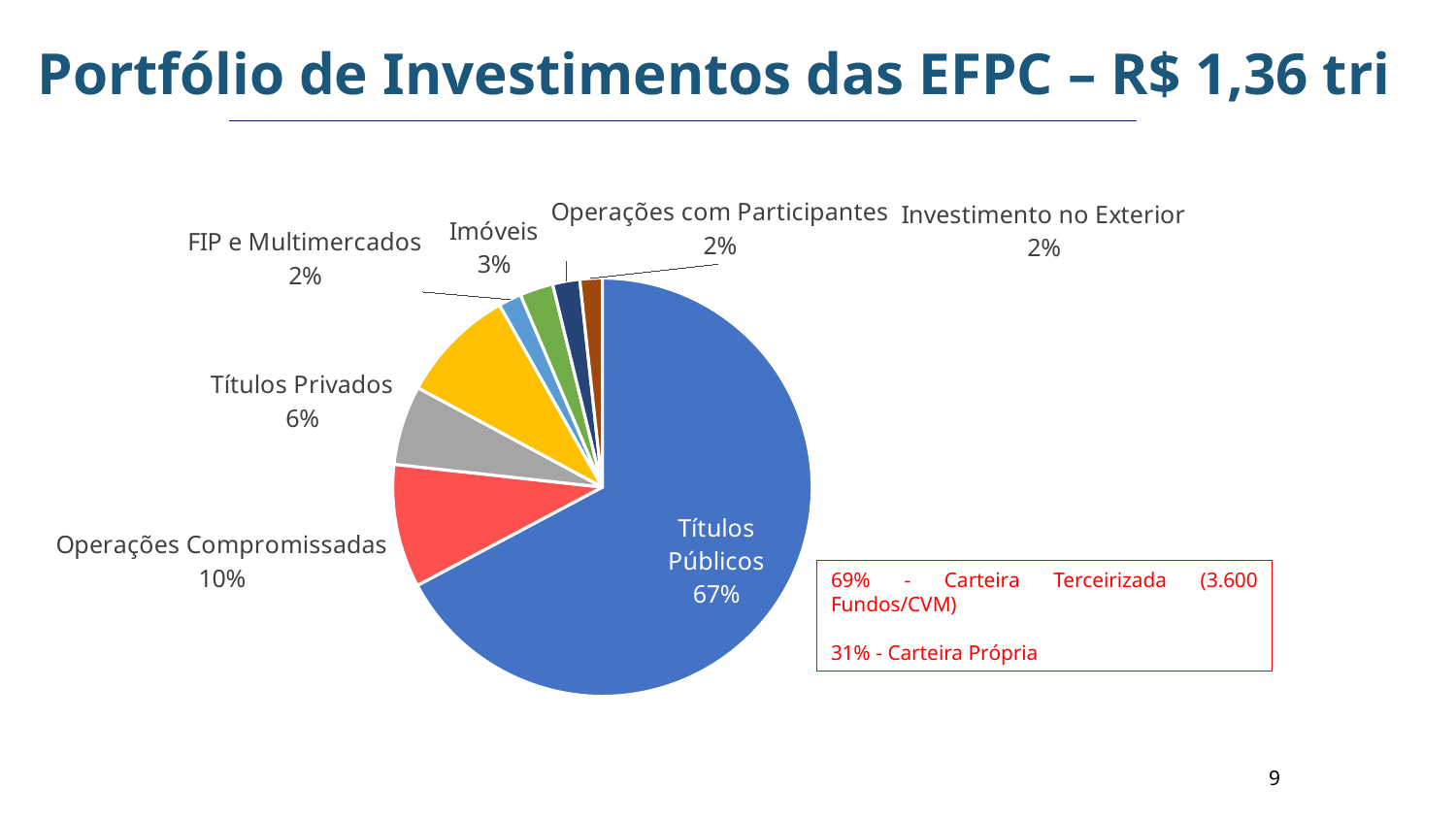
What kind of chart is shown on the slide? pie chart What is the value shown for Operações Compromissadas? 10% What is the value shown for Investimento no Exterior? 2% What is the title of the slide containing the pie chart? Portfólio de Investimentos das EFPC – R$ 1,36 tri What is the value shown for Títulos Privados? 6% What share of the pie does Títulos Públicos represent? 67% Which is larger, the share for Títulos Privados or the share for Imóveis? Títulos Privados Which category has the largest slice of the pie? Títulos Públicos What is the value shown for Imóveis? 3% What is the difference between the shares of Títulos Públicos and Operações Compromissadas? 57% What is the difference between the shares of Operações Compromissadas and Títulos Privados? 4% How many slices does the pie chart have? 8